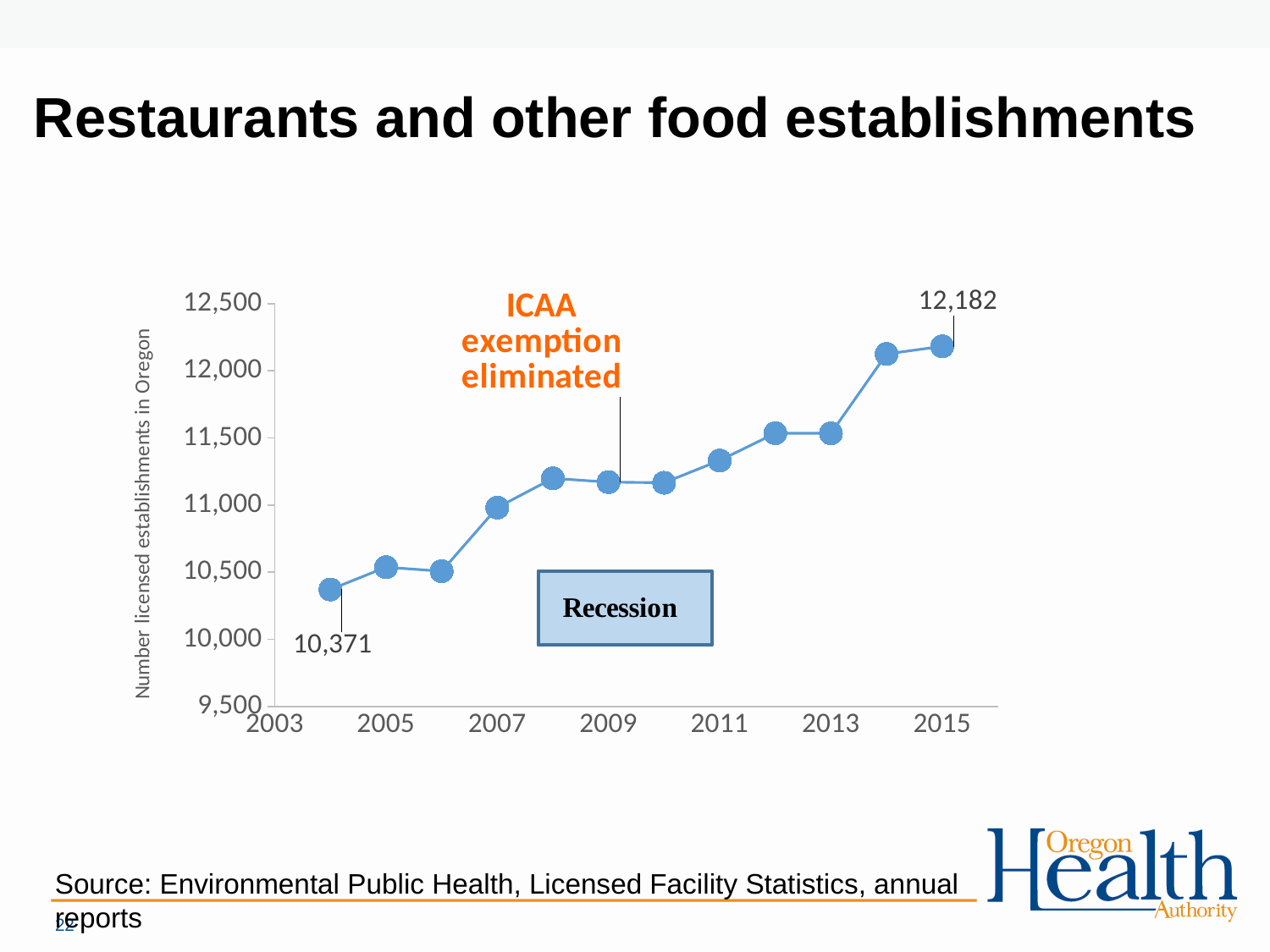
Is the value for 2008 greater or less than 11,000? greater What event does the annotation above the 2009 data point refer to? ICAA exemption eliminated What is the number of licensed establishments in Oregon in 2015? 12,182 Which year has the lowest number of licensed establishments? 2004 Which year has the highest number of licensed establishments? 2015 What is the number of licensed establishments in Oregon in 2004? 10,371 How many data points are plotted on the line? 12 Is the value for 2011 greater or less than 11,500? less What kind of chart is shown on the slide? Line chart Which year has a larger value, 2008 or 2005? 2008 Do the values generally rise or fall from 2004 to 2015? Rise By how much did the number of licensed establishments increase from 2004 to 2015? 1,811